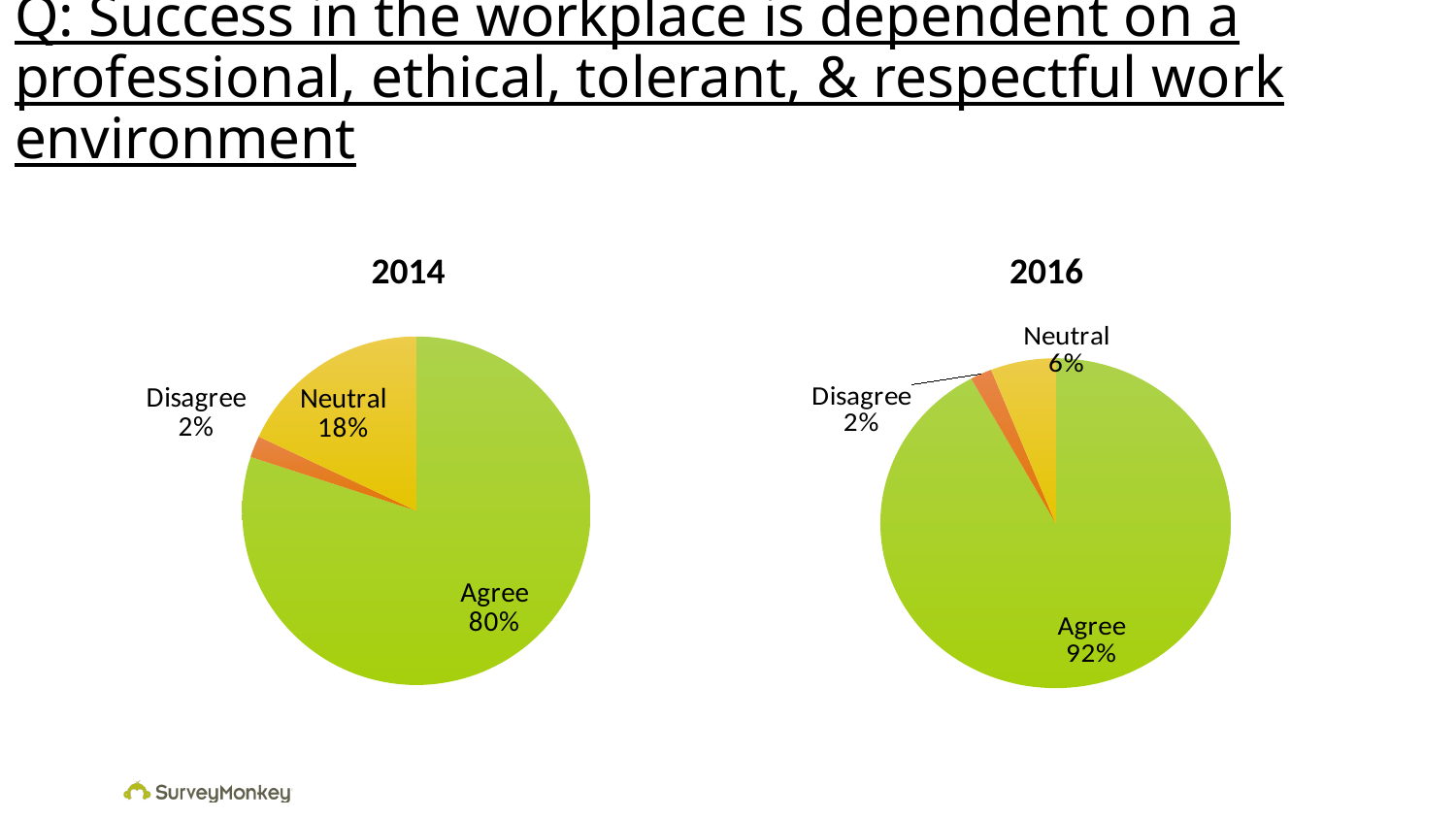
In the 2016 pie chart, which category has the largest slice? Agree In the 2016 pie chart, what colour is the Agree slice? Green In the 2014 pie chart, what percentage of respondents chose Agree? 80% What is the title of the chart on the right side of the slide? 2016 How many categories are shown in the 2016 pie chart? 3 What is the difference between the Agree share in 2016 and the Agree share in 2014? 12% In the 2014 pie chart, what is the share for Disagree? 2% Which is larger: the Neutral share in 2014 or the Neutral share in 2016? 2014 What type of chart is used for the 2014 data? Pie chart In the 2014 pie chart, what is the difference between the Neutral and Disagree shares? 16% In the 2014 pie chart, which category has the smallest slice? Disagree In the 2016 pie chart, what percentage of respondents chose Neutral? 6%